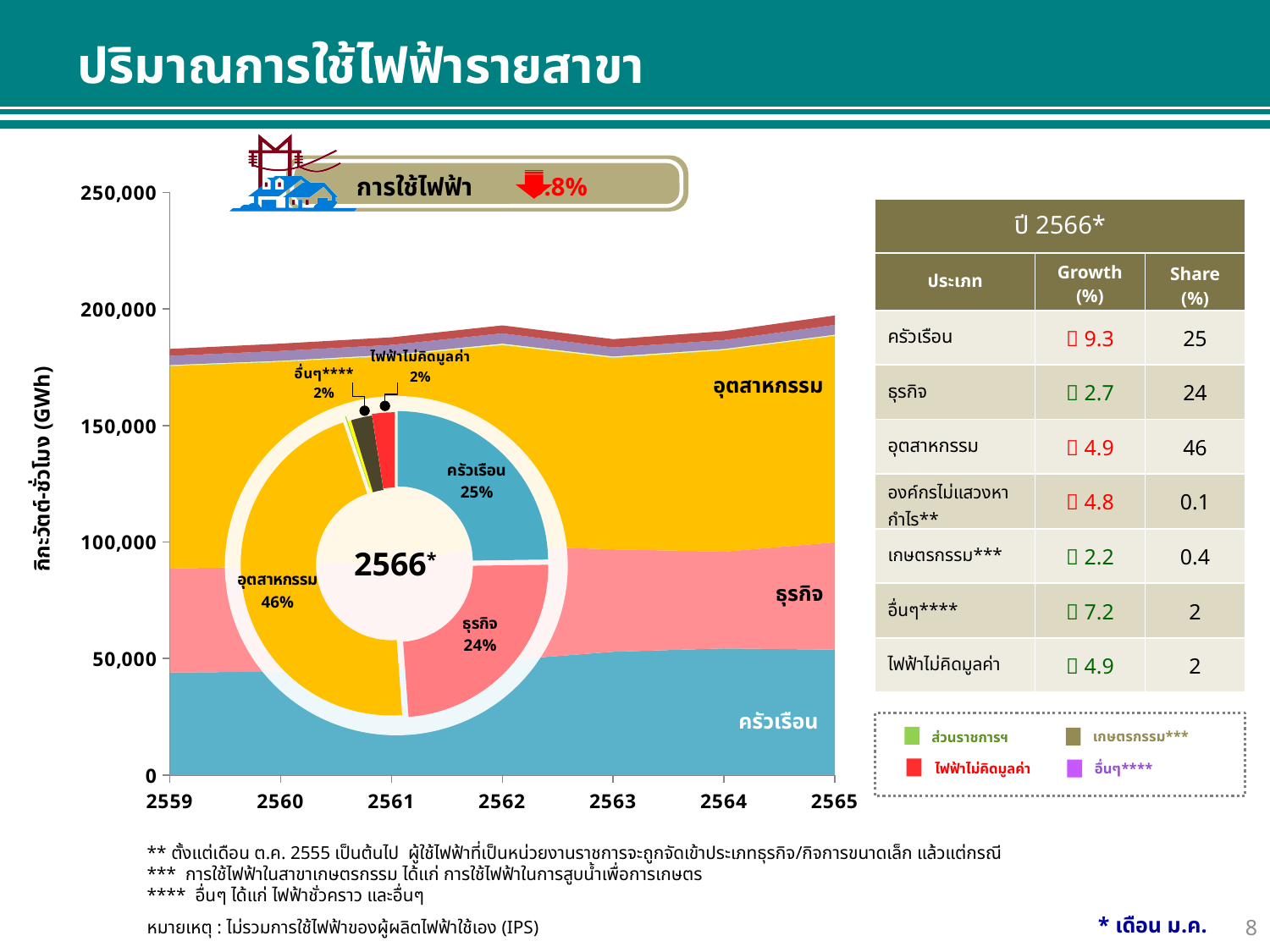
What kind of chart is the large chart with years 2559 to 2565 on the x axis? area chart In the area chart, does the ครัวเรือน area rise or fall from 2559 to 2565? rise In the 2566* pie chart, what is the difference in percentage points between the shares of อุตสาหกรรม and ธุรกิจ? 22 In the area chart, is the total stacked value for 2559 greater or less than 150,000? greater In the 2566* pie chart, which category has the largest share? อุตสาหกรรม What kind of chart is the circular chart in the centre of the slide labelled 2566*? doughnut chart In the 2566* pie chart, what share does ครัวเรือน have? 25% In the 2566* pie chart, what share does ธุรกิจ have? 24% In the 2566* pie chart, which has the larger share, ครัวเรือน or ธุรกิจ? ครัวเรือน In the 2566* pie chart, what share does อุตสาหกรรม have? 46% How many years are shown on the x axis of the area chart? 7 In the area chart, is the value for ครัวเรือน in 2559 greater or less than 50,000? less